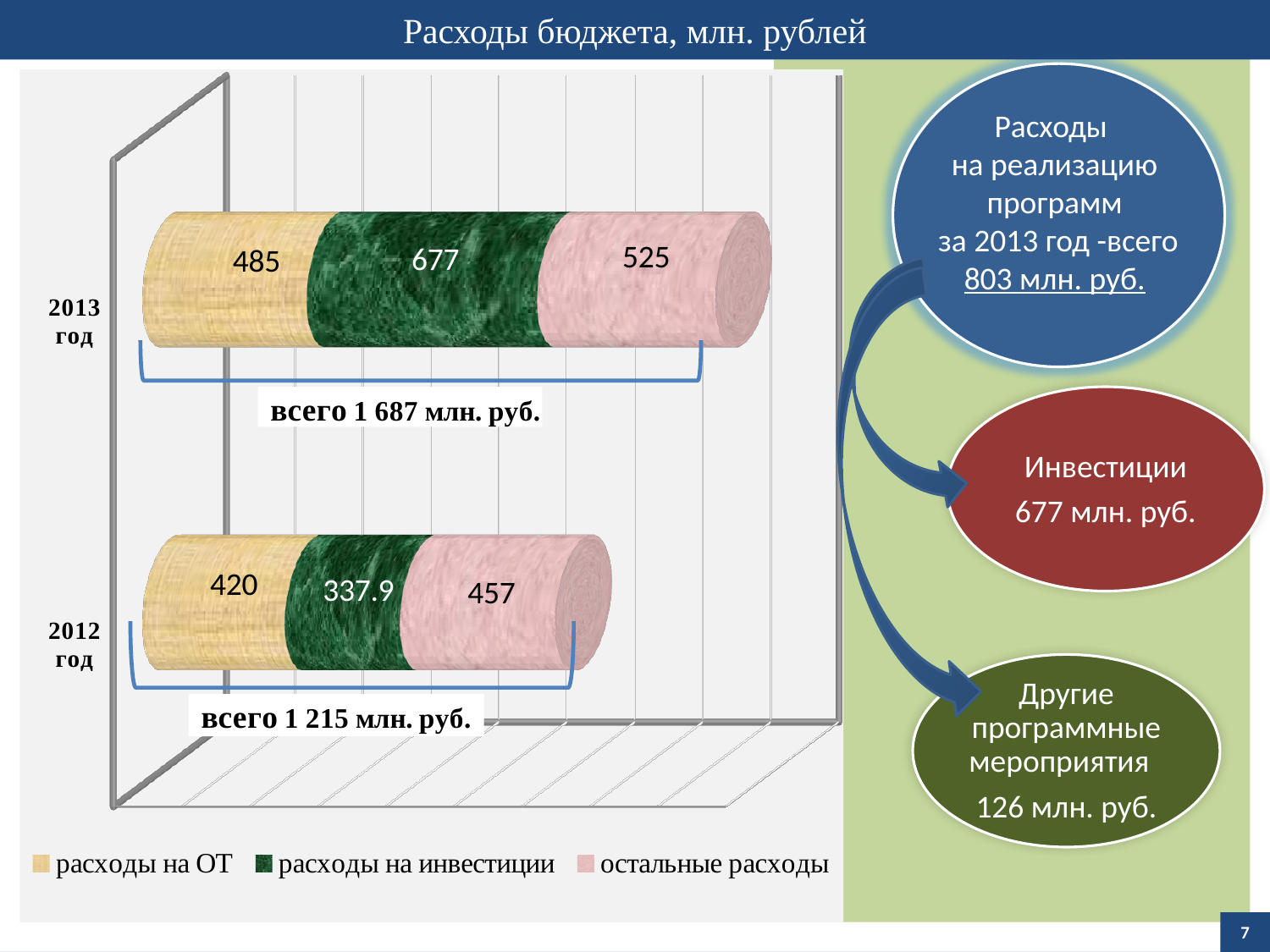
Which series has the highest value in 2013 год? расходы на инвестиции What is the difference between расходы на инвестиции in 2013 год and in 2012 год? 339.1 Which is larger: остальные расходы in 2013 год or in 2012 год? 2013 год What is the total of the stacked bar for 2012 год, as labelled on the slide? всего 1 215 млн. руб. What is the total of the stacked bar for 2013 год, as labelled on the slide? всего 1 687 млн. руб. What kind of chart is shown on the slide? stacked bar chart What is the value of расходы на ОТ for 2012 год? 420 What is the value of расходы на инвестиции for 2013 год? 677 What is the value of расходы на инвестиции for 2012 год? 337.9 What is the value of остальные расходы for 2013 год? 525 What is the difference between расходы на ОТ in 2013 год and in 2012 год? 65 How many series does the legend list? 3